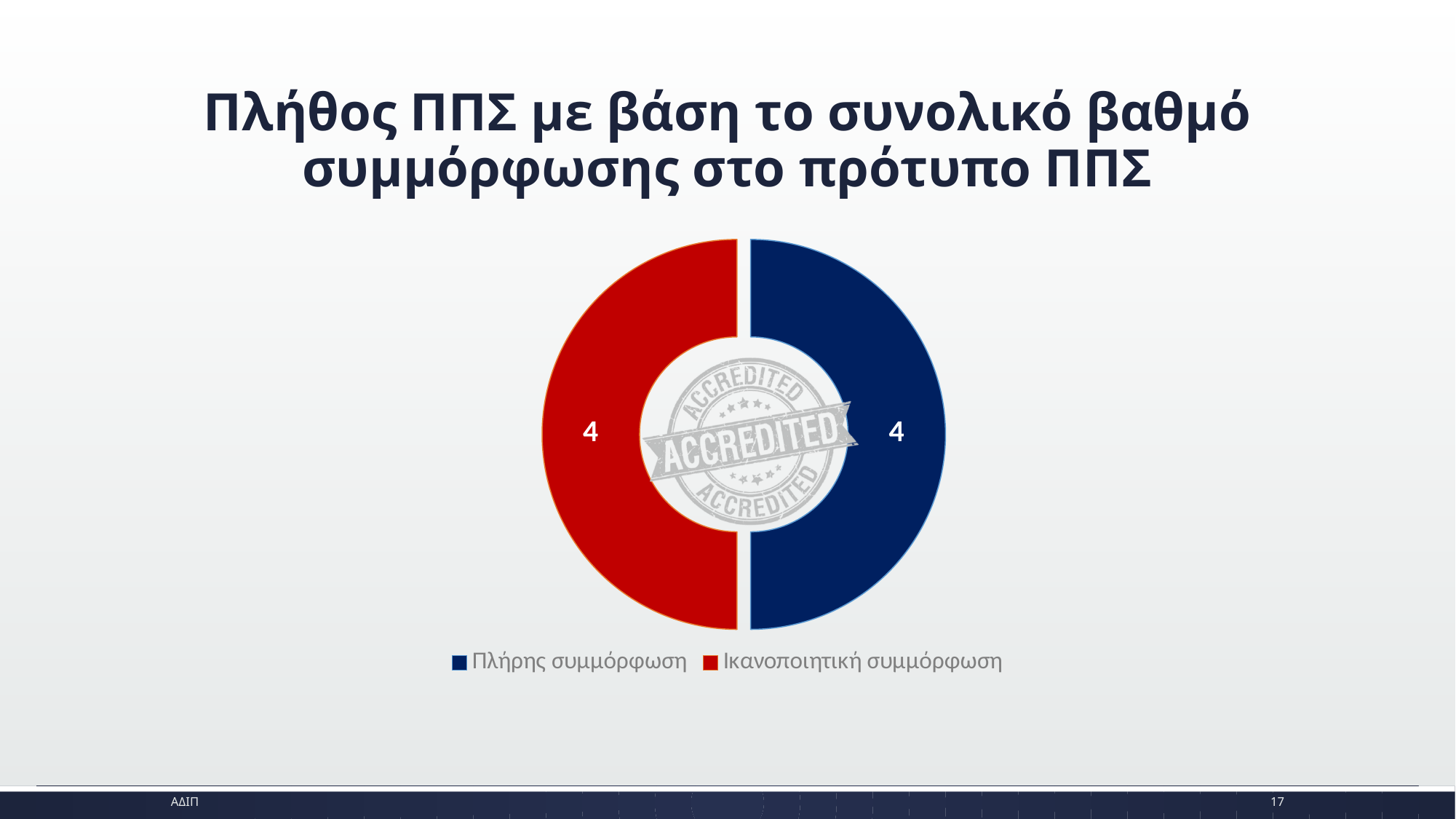
Which colour represents Ικανοποιητική συμμόρφωση in the chart? Red What kind of chart is shown on the slide? Doughnut (pie) chart How many entries does the legend list? 2 Is the value for Πλήρης συμμόρφωση larger than, smaller than, or equal to the value for Ικανοποιητική συμμόρφωση? Equal How many categories does the chart show? 2 What share of the total does Πλήρης συμμόρφωση represent? 50% What is the value for Πλήρης συμμόρφωση? 4 What is the value for Ικανοποιητική συμμόρφωση? 4 What share of the total does Ικανοποιητική συμμόρφωση represent? 50% What is the title of the chart on the slide? Πλήθος ΠΠΣ με βάση το συνολικό βαθμό συμμόρφωσης στο πρότυπο ΠΠΣ What is the difference between the values for Πλήρης συμμόρφωση and Ικανοποιητική συμμόρφωση? 0 What is the total of all values shown in the chart? 8